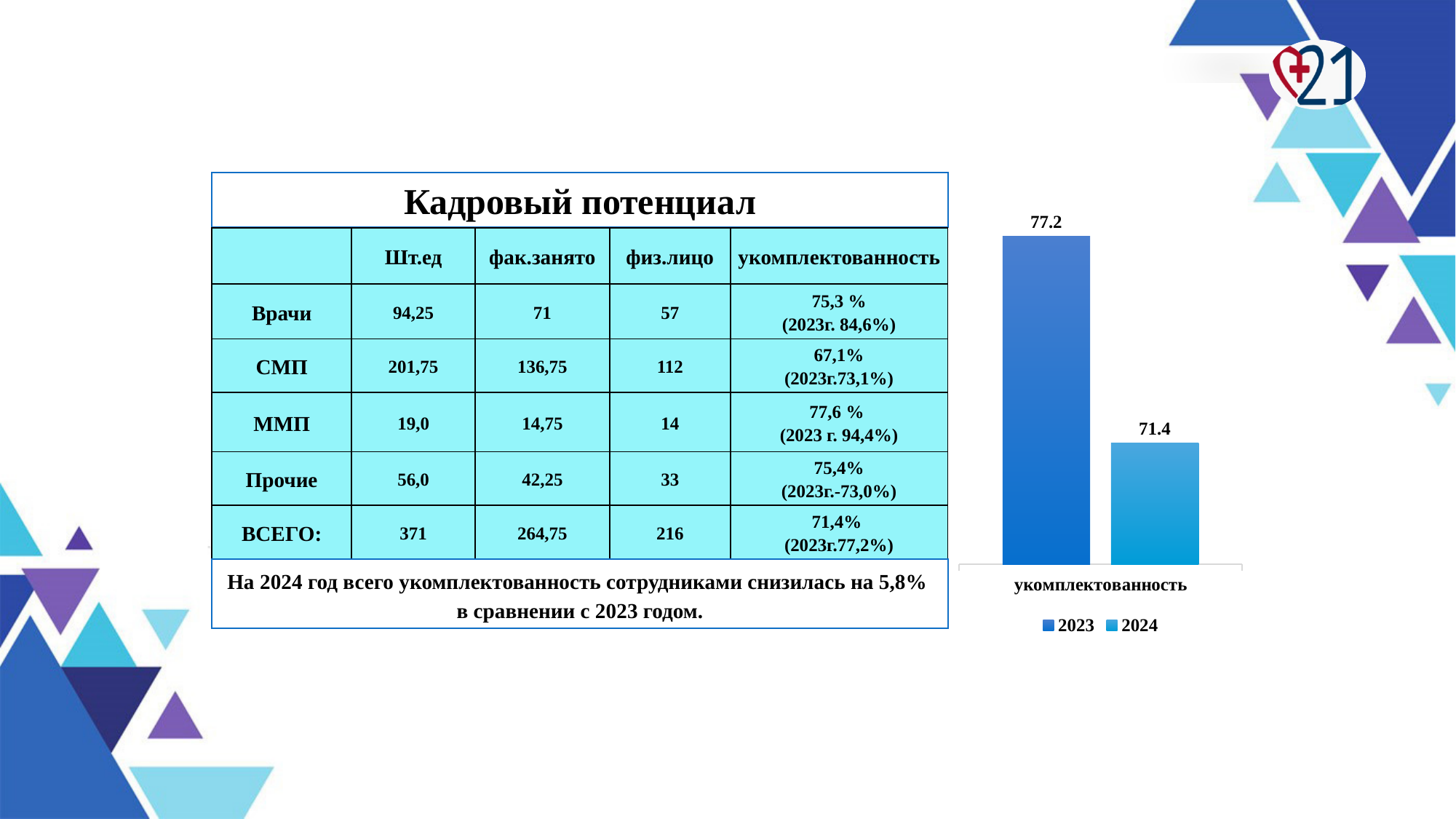
Which series has the higher bar in the chart, 2023 or 2024? 2023 Did the value rise or fall from 2023 to 2024 according to the chart? fall What is the value of the 2024 bar in the chart? 71.4 Is the 2024 value larger or smaller than the 2023 value in the chart? smaller What is the category label shown under the bars in the chart? укомплектованность What entries does the chart legend list? 2023, 2024 What type of chart is shown on the slide? bar chart What is the value of the 2023 bar in the chart? 77.2 By how much does the 2023 value exceed the 2024 value in the chart? 5.8 Which series has the lower bar in the chart? 2024 How many categories are shown on the x axis of the chart? 1 How many series does the chart legend list? 2